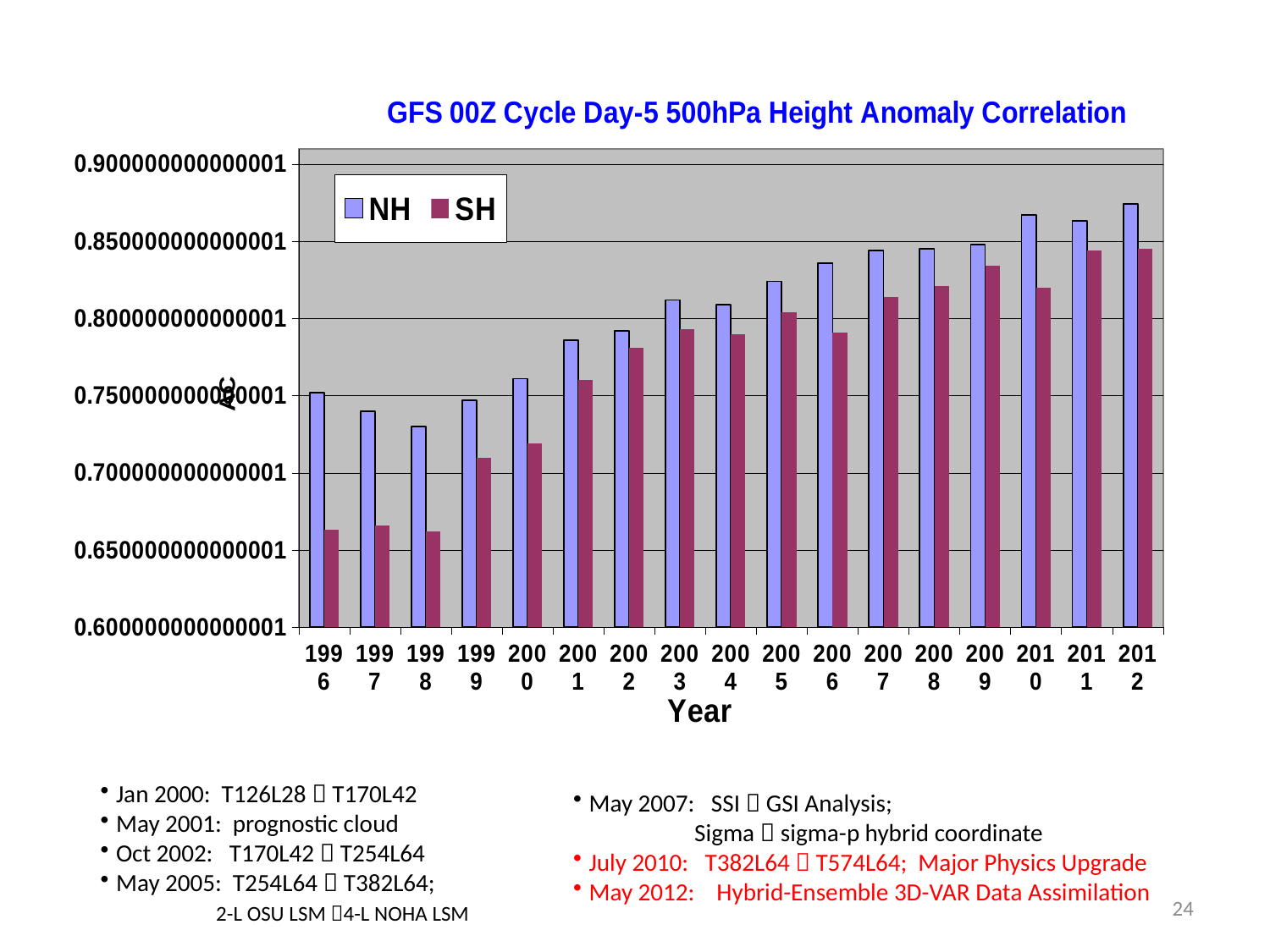
How many years are shown along the x axis? 17 Which year has the highest NH value? 2012 Overall, do the NH values rise or fall from 1996 to 2012? rise What is the title of the chart? GFS 00Z Cycle Day-5 500hPa Height Anomaly Correlation Is the SH value for 1996 greater or less than 0.65? greater Is the NH value for 2012 greater or less than 0.85? greater Is the NH value for 2005 greater or less than 0.80? greater Which year has the lowest NH value? 1998 In 1996, which is larger, the NH value or the SH value? NH How many series does the legend list? 2 What kind of chart is shown on the slide? Bar chart